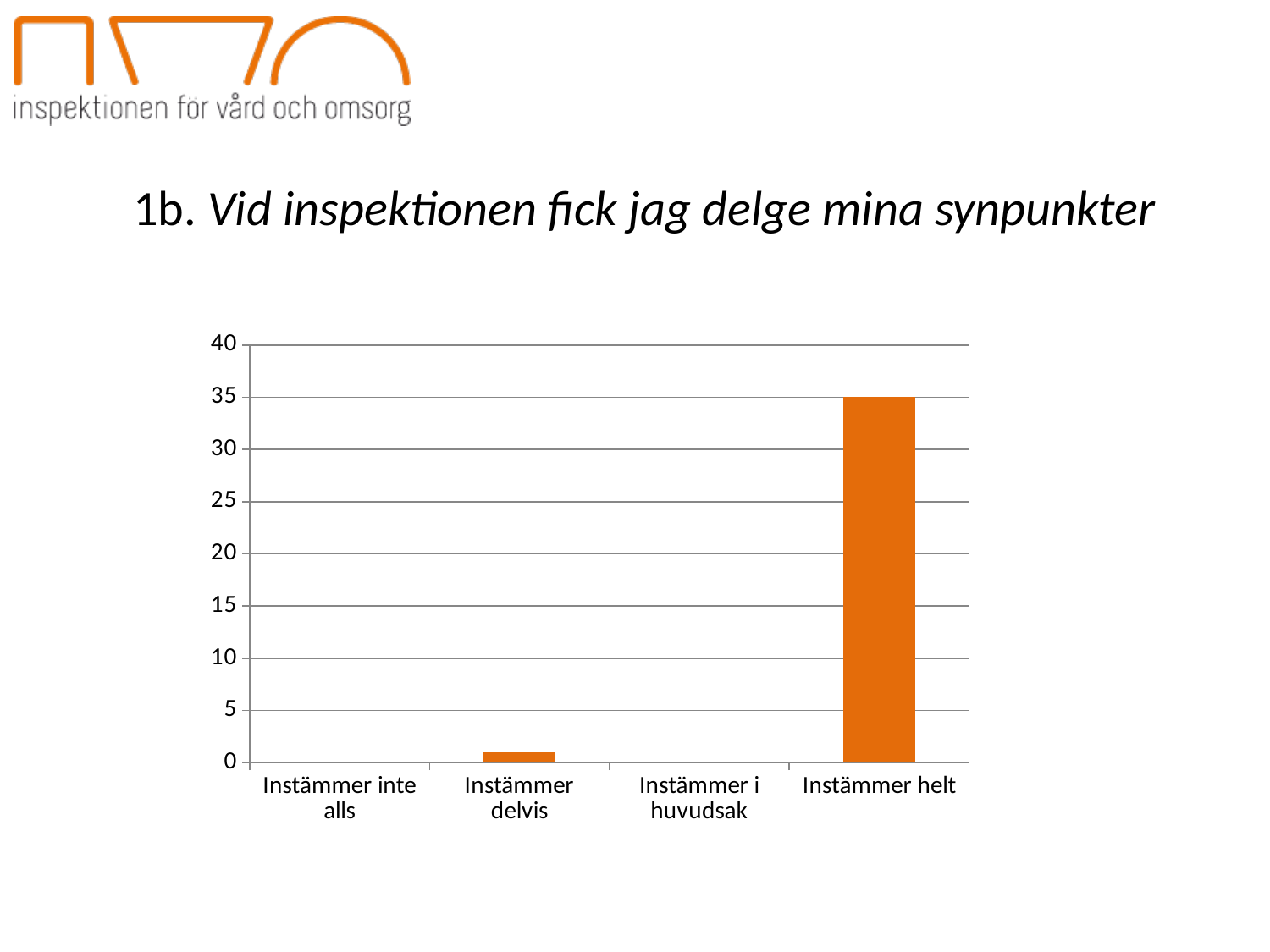
Is the value for Instämmer helt greater or less than 40? less Which category has the highest value in the chart? Instämmer helt What is the highest value shown on the y axis of the chart? 40 What is the title of the slide above the chart? 1b. Vid inspektionen fick jag delge mina synpunkter Is the value for Instämmer delvis greater or less than 5? less What colour are the bars in the chart? orange How many categories are shown on the x axis of the chart? 4 What kind of chart is shown on the slide? bar chart Which is larger, the value for Instämmer helt or the value for Instämmer delvis? Instämmer helt What is the value for Instämmer helt? 35 Is the value for Instämmer helt greater or less than 30? greater